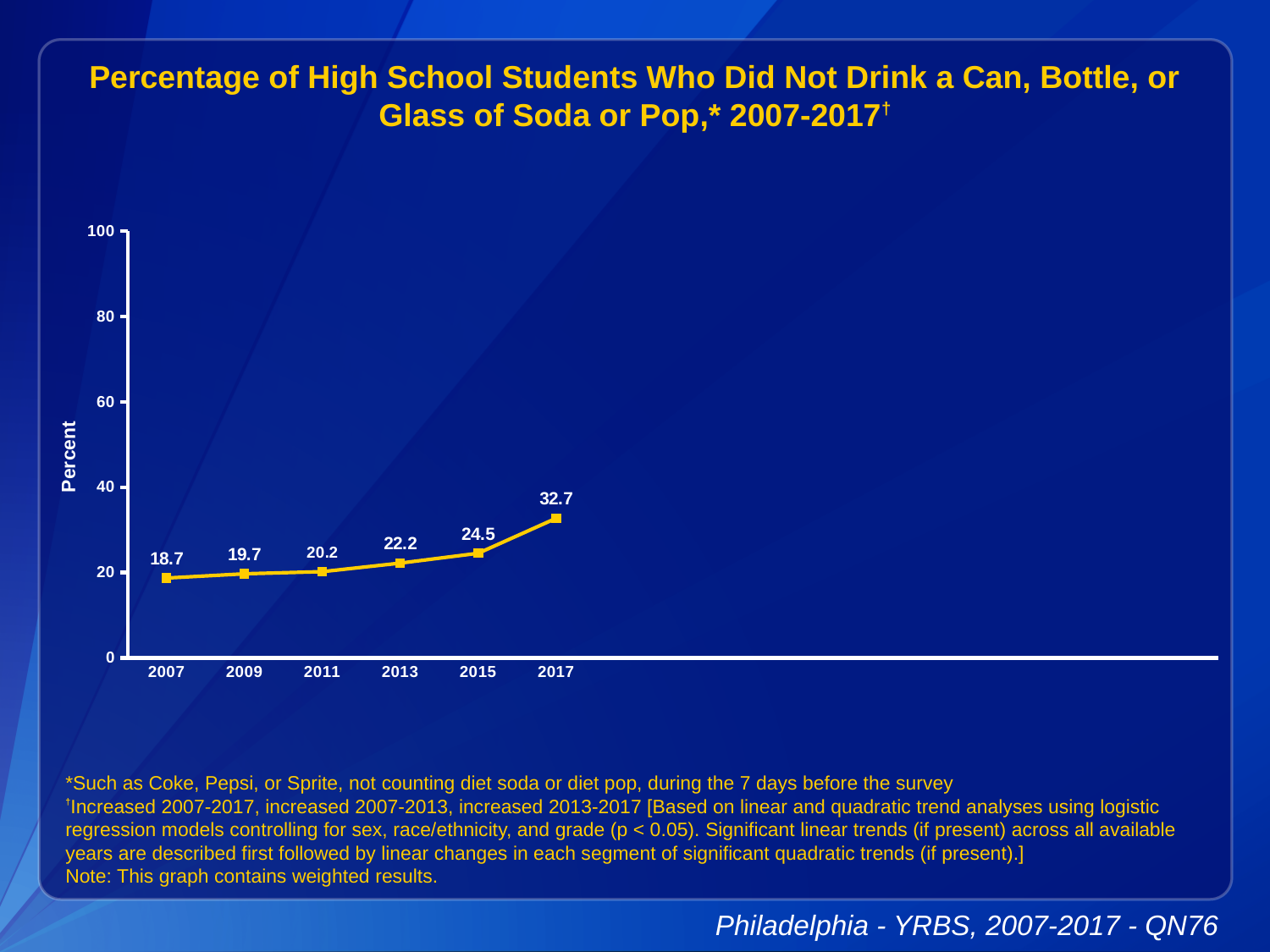
What is the value for 2017? 32.7 What is the value for 2013? 22.2 How many years are plotted on the chart? 6 What is the value for 2007? 18.7 What is the difference between the values for 2017 and 2007? 14 Which year has the lowest value? 2007 Which year has the highest value? 2017 Do the values rise or fall from 2007 to 2017? rise Which is larger, the value for 2011 or the value for 2015? 2015 Is the value for 2017 greater or less than 40? less What kind of chart is shown? line chart What is the difference between the values for 2017 and 2015? 8.2